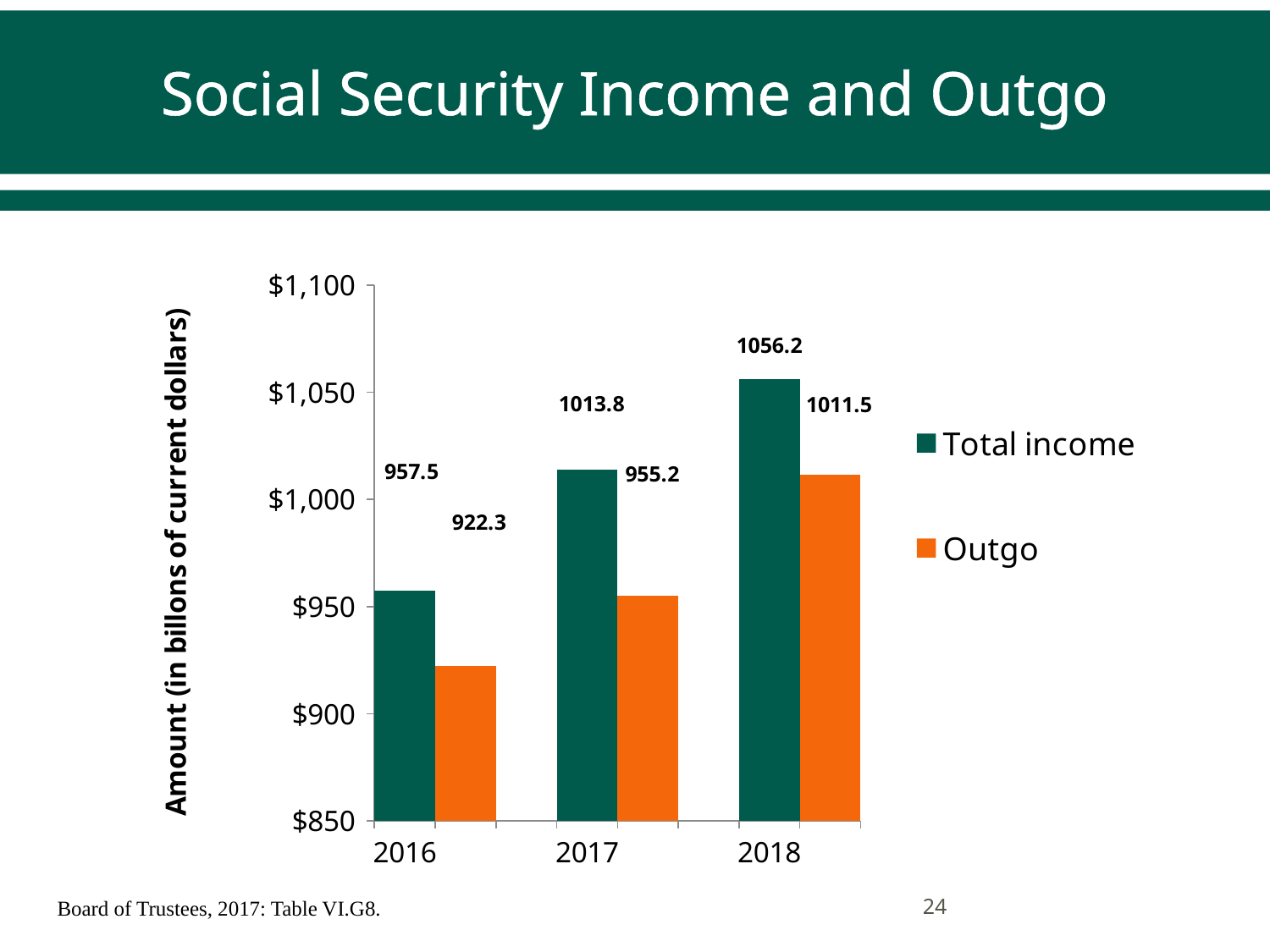
Does Outgo rise or fall from 2016 to 2018? Rise Which year has the highest Total income? 2018 What is the difference between Total income and Outgo in 2018? 44.7 How many series does the legend list? 2 What kind of chart is shown on the slide? Bar chart What is the Outgo value for 2016? 922.3 How many years are shown on the x axis? 3 What is the Total income value for 2017? 1013.8 Which year has the lowest Outgo? 2016 Which is larger in 2017, Total income or Outgo? Total income What is the Outgo value for 2018? 1011.5 What is the difference between Total income in 2017 and Total income in 2016? 56.3